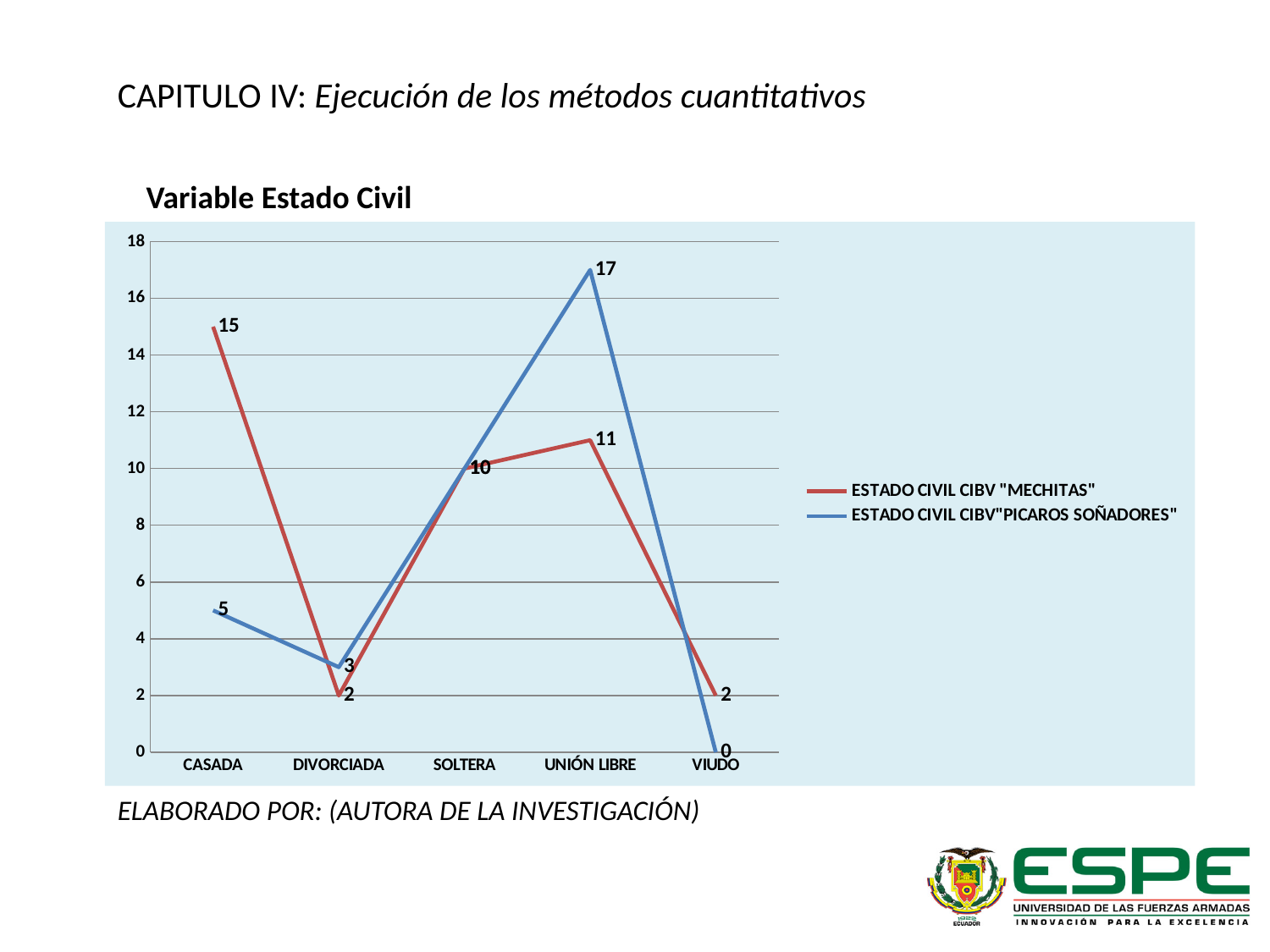
How many series does the legend list? 2 Which category has the highest value in the ESTADO CIVIL CIBV "MECHITAS" series? CASADA For UNIÓN LIBRE, which series has the larger value? ESTADO CIVIL CIBV"PICAROS SOÑADORES" What is the value for CASADA in the ESTADO CIVIL CIBV "MECHITAS" series? 15 What is the difference between the two series' values for CASADA? 10 What is the value for UNIÓN LIBRE in the ESTADO CIVIL CIBV"PICAROS SOÑADORES" series? 17 What is the title of the chart? Variable Estado Civil How many categories are shown on the x axis? 5 What is the value for VIUDO in the ESTADO CIVIL CIBV"PICAROS SOÑADORES" series? 0 Which category has the lowest value in the ESTADO CIVIL CIBV"PICAROS SOÑADORES" series? VIUDO What is the difference between the UNIÓN LIBRE and DIVORCIADA values in the ESTADO CIVIL CIBV "MECHITAS" series? 9 What kind of chart is shown on the slide? line chart